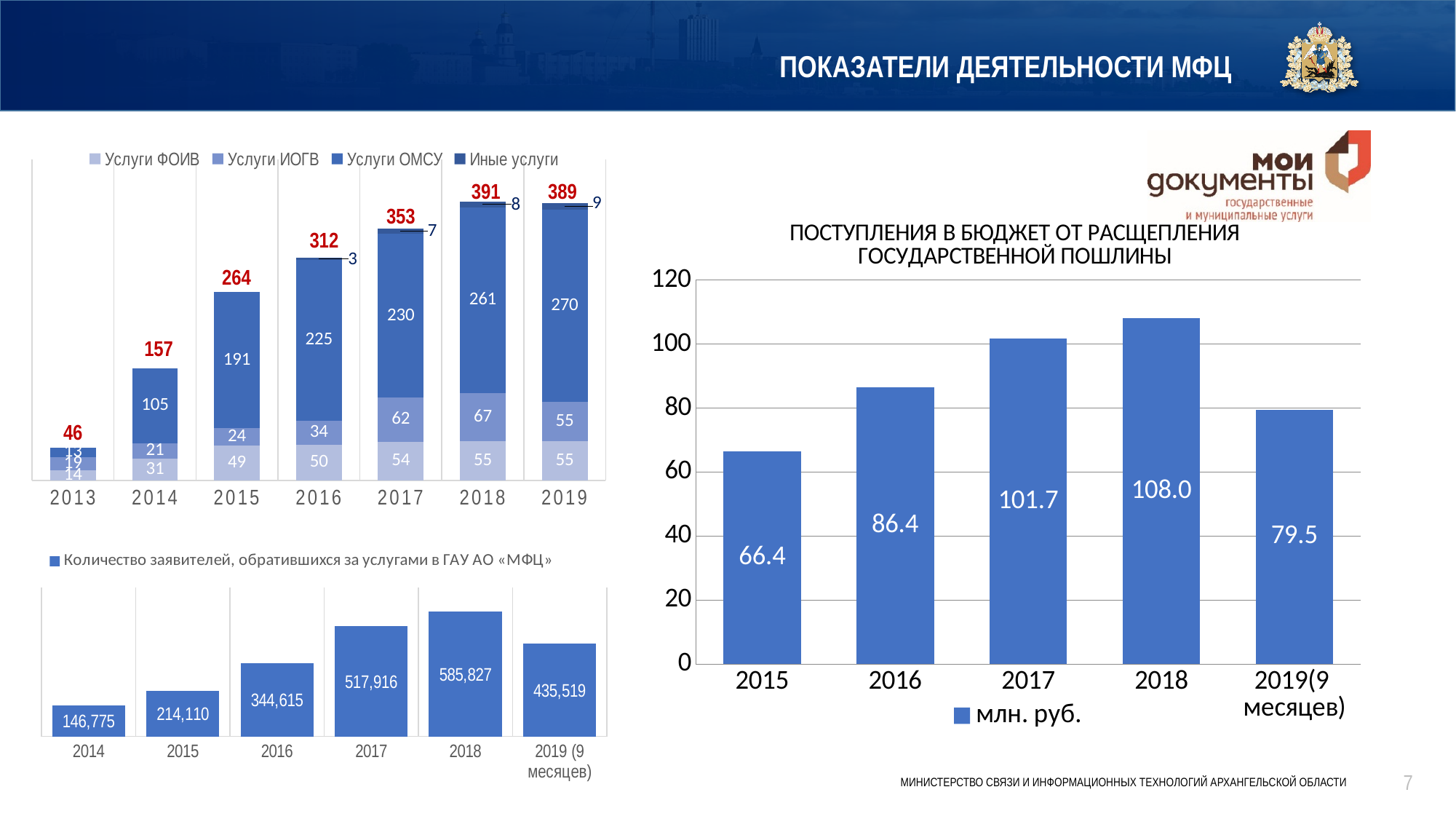
In the top-left stacked chart of services, what is the value of «Услуги ОМСУ» for 2016? 225 In the chart titled «ПОСТУПЛЕНИЯ В БЮДЖЕТ ОТ РАСЩЕПЛЕНИЯ ГОСУДАРСТВЕННОЙ ПОШЛИНЫ», what is the value for 2017? 101.7 In the chart titled «ПОСТУПЛЕНИЯ В БЮДЖЕТ ОТ РАСЩЕПЛЕНИЯ ГОСУДАРСТВЕННОЙ ПОШЛИНЫ», how many bars are plotted? 5 In the bottom-left chart «Количество заявителей, обратившихся за услугами в ГАУ АО «МФЦ»», what is the value for 2018? 585,827 In the chart titled «ПОСТУПЛЕНИЯ В БЮДЖЕТ ОТ РАСЩЕПЛЕНИЯ ГОСУДАРСТВЕННОЙ ПОШЛИНЫ», do the values rise or fall from 2015 to 2018? rise In the chart titled «ПОСТУПЛЕНИЯ В БЮДЖЕТ ОТ РАСЩЕПЛЕНИЯ ГОСУДАРСТВЕННОЙ ПОШЛИНЫ», which year has the highest value? 2018 In the bottom-left chart «Количество заявителей, обратившихся за услугами в ГАУ АО «МФЦ»», which is larger: the value for 2017 or for 2019 (9 месяцев)? 2017 In the chart titled «ПОСТУПЛЕНИЯ В БЮДЖЕТ ОТ РАСЩЕПЛЕНИЯ ГОСУДАРСТВЕННОЙ ПОШЛИНЫ», what unit does the legend show? млн. руб. In the top-left stacked chart of services, what is the total shown above the 2018 bar? 391 In the chart titled «ПОСТУПЛЕНИЯ В БЮДЖЕТ ОТ РАСЩЕПЛЕНИЯ ГОСУДАРСТВЕННОЙ ПОШЛИНЫ», what is the difference between the 2018 and 2015 values? 41.6 In the bottom-left chart «Количество заявителей, обратившихся за услугами в ГАУ АО «МФЦ»», which year has the lowest value? 2014 In the top-left stacked chart of services, how many series does the legend list? 4